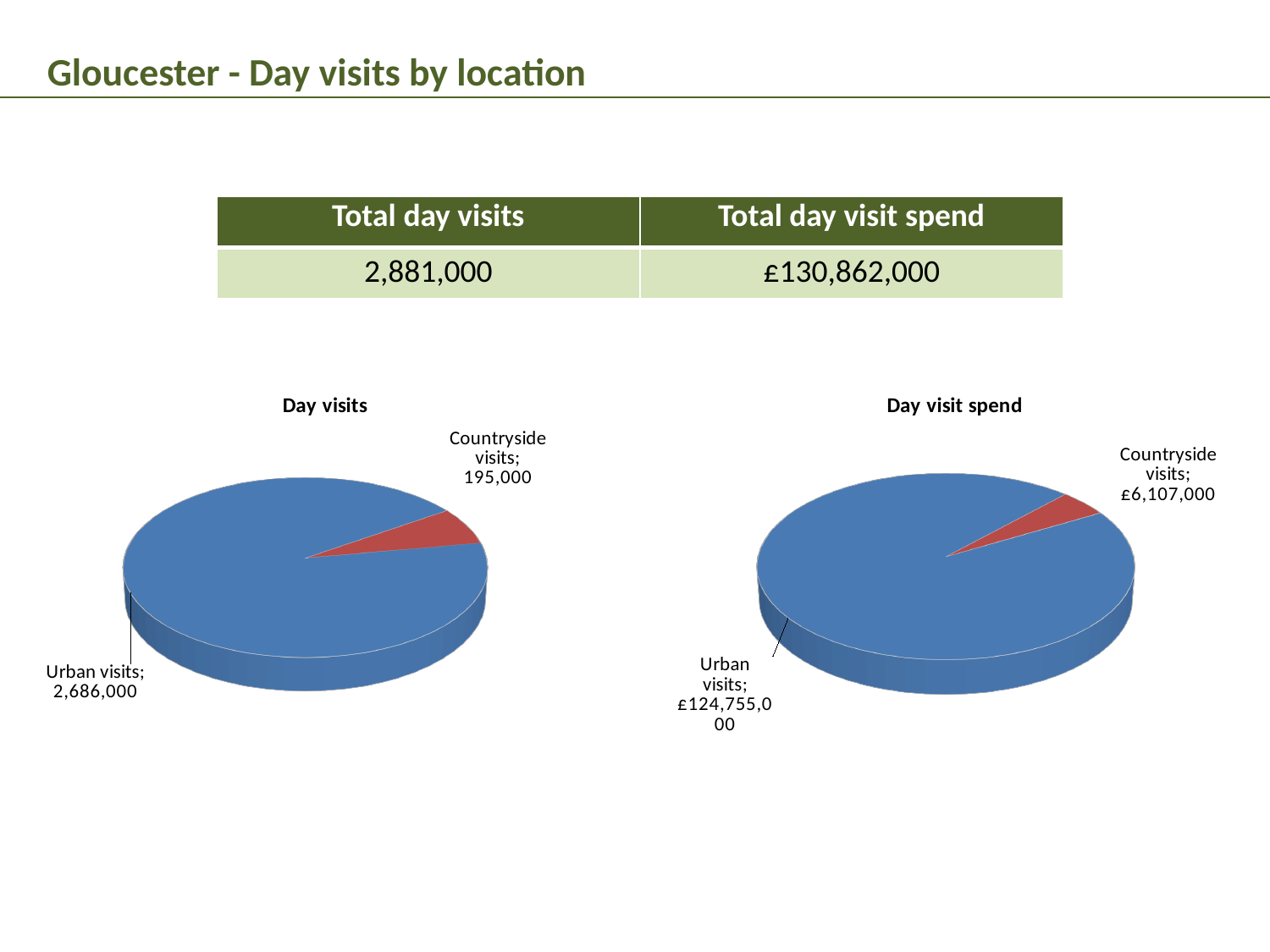
How many slices does the "Day visits" pie chart have? 2 In the "Day visit spend" chart, which category has the smallest slice? Countryside visits In the "Day visit spend" chart, which is larger, Urban visits or Countryside visits? Urban visits In the "Day visit spend" chart, what is the value for Countryside visits? £6,107,000 In the "Day visits" chart, which category has the largest slice? Urban visits In the "Day visit spend" chart, what is the value for Urban visits? £124,755,000 In the "Day visits" chart, what is the value for Urban visits? 2,686,000 In the "Day visits" chart, what colour is the Countryside visits slice? Red In the "Day visits" chart, what is the value for Countryside visits? 195,000 In the "Day visit spend" chart, what is the difference between Urban visits and Countryside visits? £118,648,000 In the "Day visits" chart, how much larger is Urban visits than Countryside visits? 2,491,000 What kind of chart is the "Day visits" chart? Pie chart